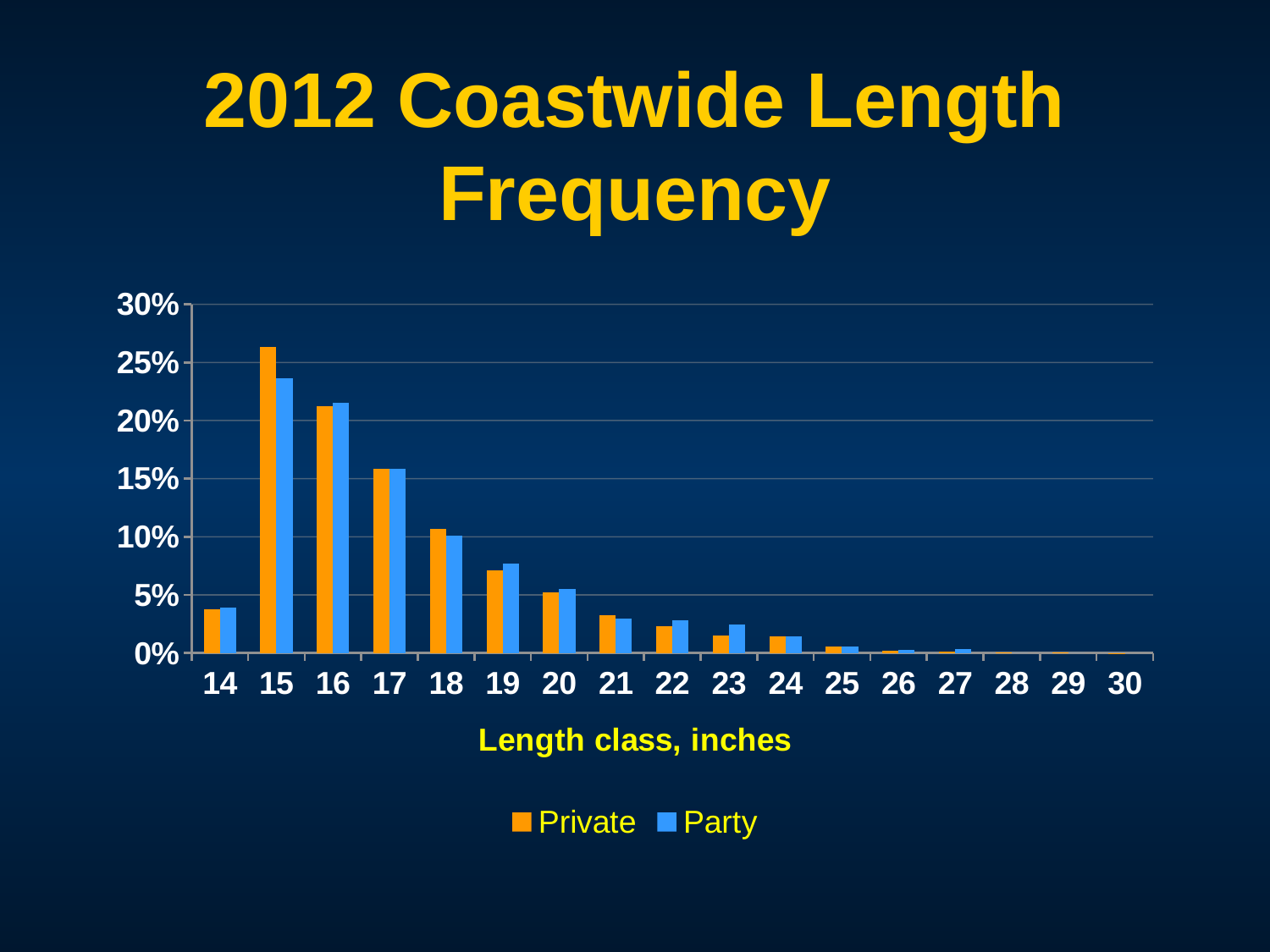
Is the Private value for length class 15 greater or less than 25%? greater At length class 23, which series has the larger value, Private or Party? Party Is the Party value for length class 15 greater or less than 25%? less Is the Party value for length class 19 greater or less than 5%? greater How many length classes are shown on the x axis? 17 Which length class has the highest Party value? 15 Which length class has the highest Private value? 15 What is the x-axis title of the chart? Length class, inches Do the Private values rise or fall from length class 15 to length class 30? fall How many series does the legend list? 2 At length class 15, which series has the larger value, Private or Party? Private What kind of chart is shown on the slide? bar chart